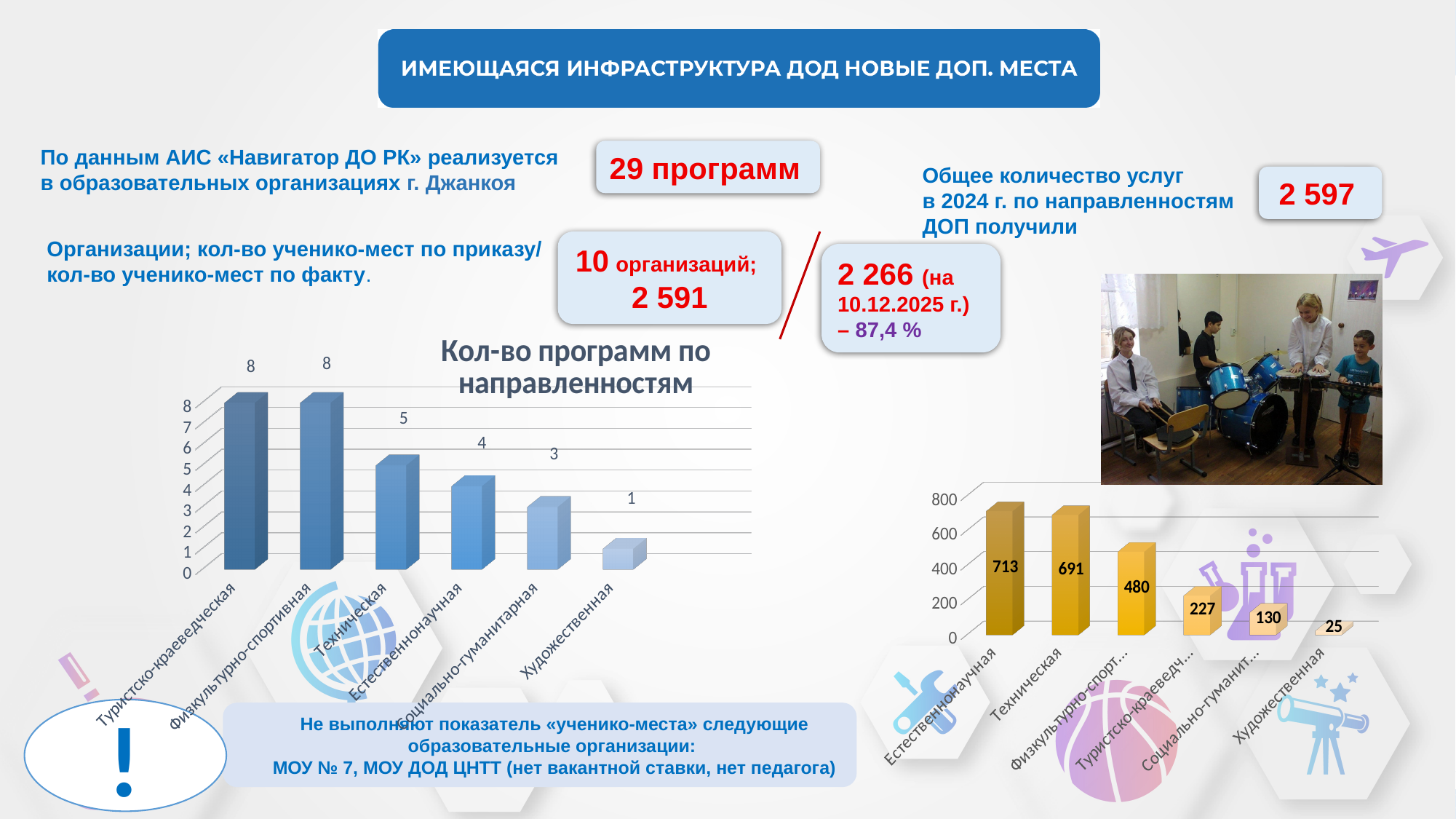
In the bar chart at the bottom right of the slide, which is larger: the value for Техническая or the value for Художественная? Техническая In the chart titled «Кол-во программ по направленностям», what is the value for Техническая? 5 In the bar chart at the bottom right of the slide, what is the difference between Техническая and Художественная? 666 In the chart titled «Кол-во программ по направленностям», do the values rise or fall from left to right along the x axis? fall In the chart titled «Кол-во программ по направленностям», what is the value for Социально-гуманитарная? 3 In the bar chart at the bottom right of the slide, which category has the highest value? Естественнонаучная What kind of chart is the one titled «Кол-во программ по направленностям»? bar chart In the chart titled «Кол-во программ по направленностям», what is the difference between Естественнонаучная and Художественная? 3 In the chart titled «Кол-во программ по направленностям», how many categories are shown? 6 In the bar chart at the bottom right of the slide, what is the value for Художественная? 25 In the bar chart at the bottom right of the slide, what is the value for Естественнонаучная? 713 In the chart titled «Кол-во программ по направленностям», which category has the lowest value? Художественная